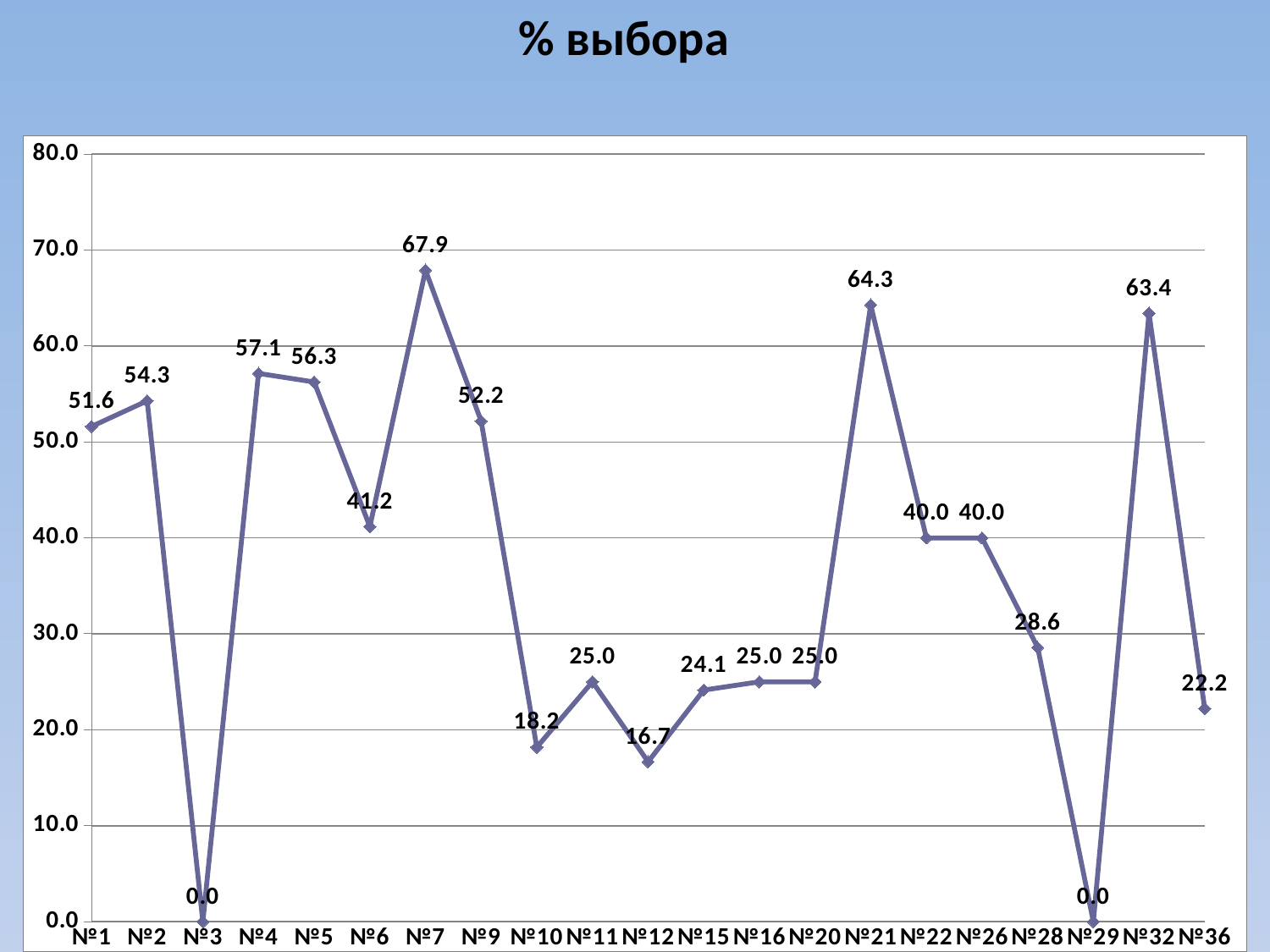
What is the difference between the values for №7 and №9? 15.7 What is the value for №12? 16.7 What is the title of the chart? % выбора How many categories have a value of 0.0? 2 Do the values rise or fall from №10 to №11? rise What type of chart is shown on the slide? line chart What is the difference between the values for №4 and №5? 0.8 Which is larger, the value for №32 or the value for №21? №21 What is the value for №21? 64.3 What is the value for №7? 67.9 How many categories are plotted on the x axis? 21 Which category has the highest value? №7